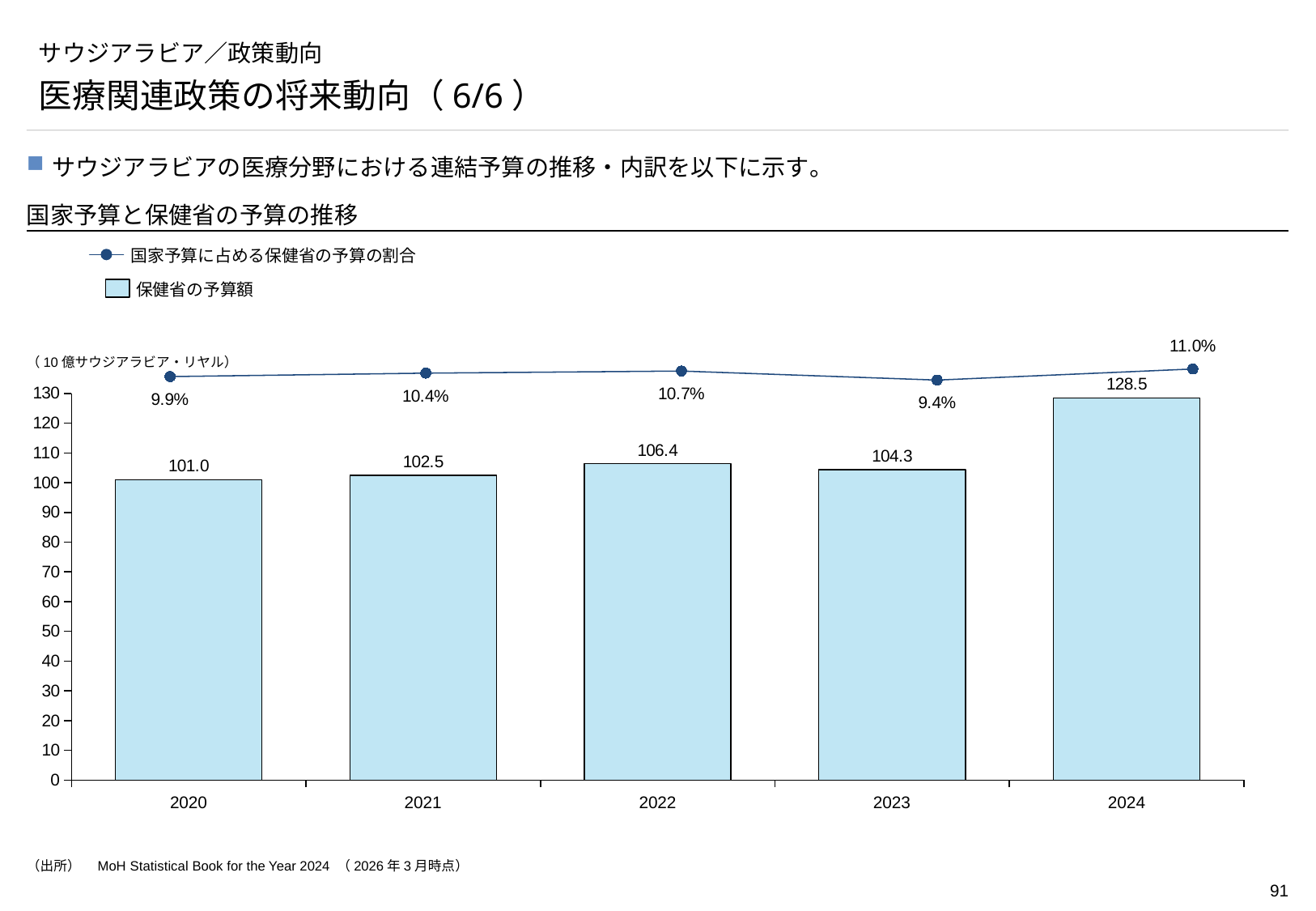
Which year has the highest 保健省の予算額? 2024 What unit is shown for the bar values? 10億サウジアラビア・リヤル Is the 保健省の予算額 for 2024 greater or less than 120? greater Does the 保健省の予算額 rise or fall from 2022 to 2023? fall What is the 国家予算に占める保健省の予算の割合 value for 2023? 9.4% How many years are shown on the x axis? 5 What is the difference in 保健省の予算額 between 2024 and 2023? 24.2 What kind of chart is used for 保健省の予算額? bar chart What is the 保健省の予算額 value for 2022? 106.4 Which year has the lowest 国家予算に占める保健省の予算の割合? 2023 How many series does the legend list? 2 Which is larger, the 保健省の予算額 for 2021 or for 2023? 2023